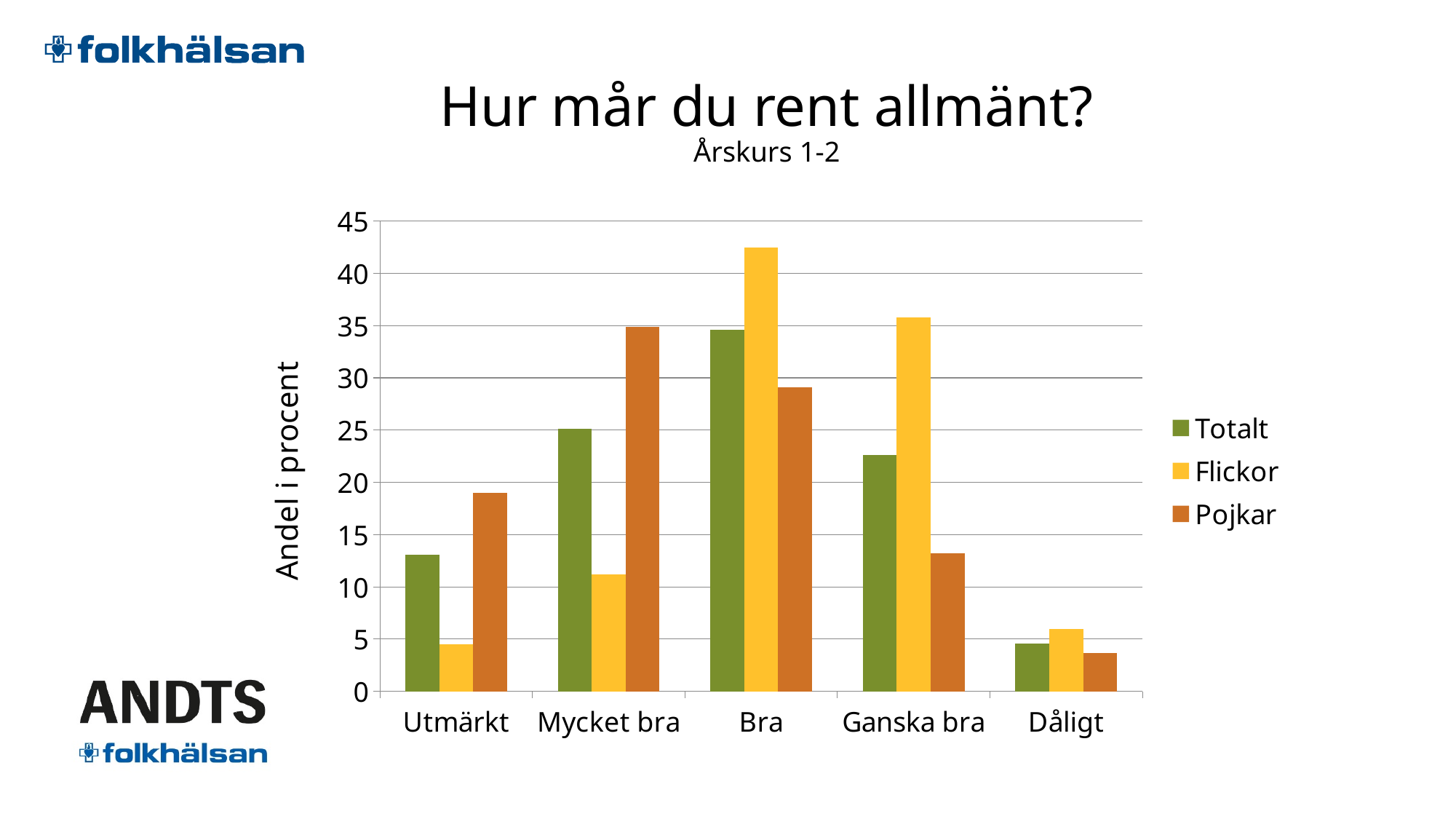
Which category has the lowest value for Pojkar? Dåligt Which category has the highest value for Pojkar? Mycket bra Is the value for Flickor in the Ganska bra category greater or less than 35? greater Is the value for Flickor in the Bra category greater or less than 40? greater In the Ganska bra category, which is larger: the value for Totalt or the value for Flickor? Flickor What kind of chart is shown on the slide? bar chart How many series does the legend list? 3 In the Utmärkt category, which is larger: the value for Flickor or the value for Pojkar? Pojkar Which category has the highest value for Flickor? Bra What is the label of the y axis? Andel i procent How many categories are shown on the x axis? 5 Is the value for Pojkar in the Utmärkt category greater or less than 20? less